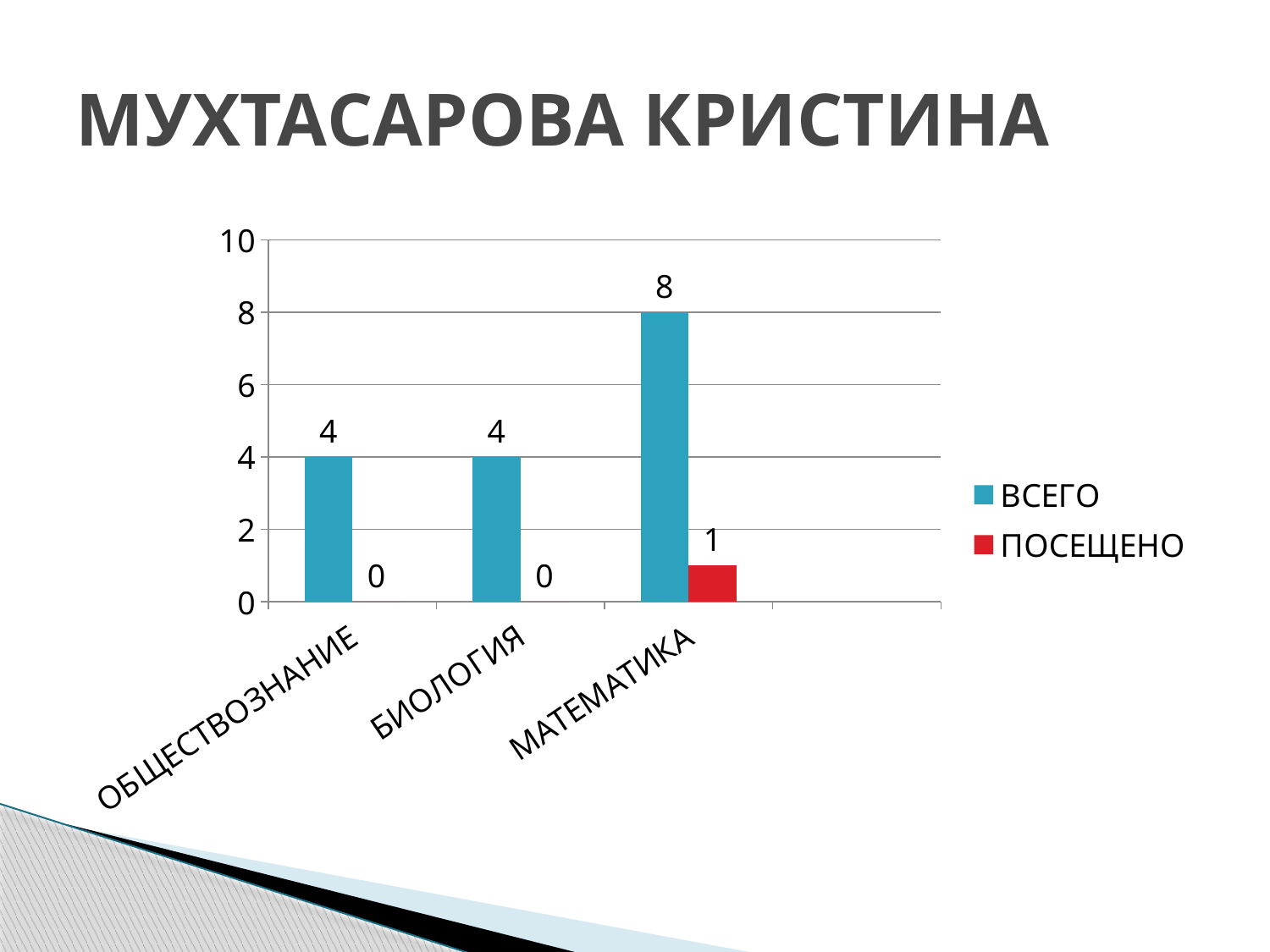
What is the ВСЕГО value for БИОЛОГИЯ? 4 Which category has the highest ПОСЕЩЕНО value? МАТЕМАТИКА What is the difference between the ВСЕГО and ПОСЕЩЕНО values for МАТЕМАТИКА? 7 What kind of chart is shown on the slide? Bar chart Which category has the highest ВСЕГО value? МАТЕМАТИКА How many categories are shown on the x axis? 3 How many series does the legend list? 2 What is the ПОСЕЩЕНО value for ОБЩЕСТВОЗНАНИЕ? 0 Which is larger: the ВСЕГО value for МАТЕМАТИКА or the ВСЕГО value for ОБЩЕСТВОЗНАНИЕ? МАТЕМАТИКА What is the ВСЕГО value for МАТЕМАТИКА? 8 What is the ПОСЕЩЕНО value for МАТЕМАТИКА? 1 What is the difference between the ВСЕГО values for МАТЕМАТИКА and БИОЛОГИЯ? 4